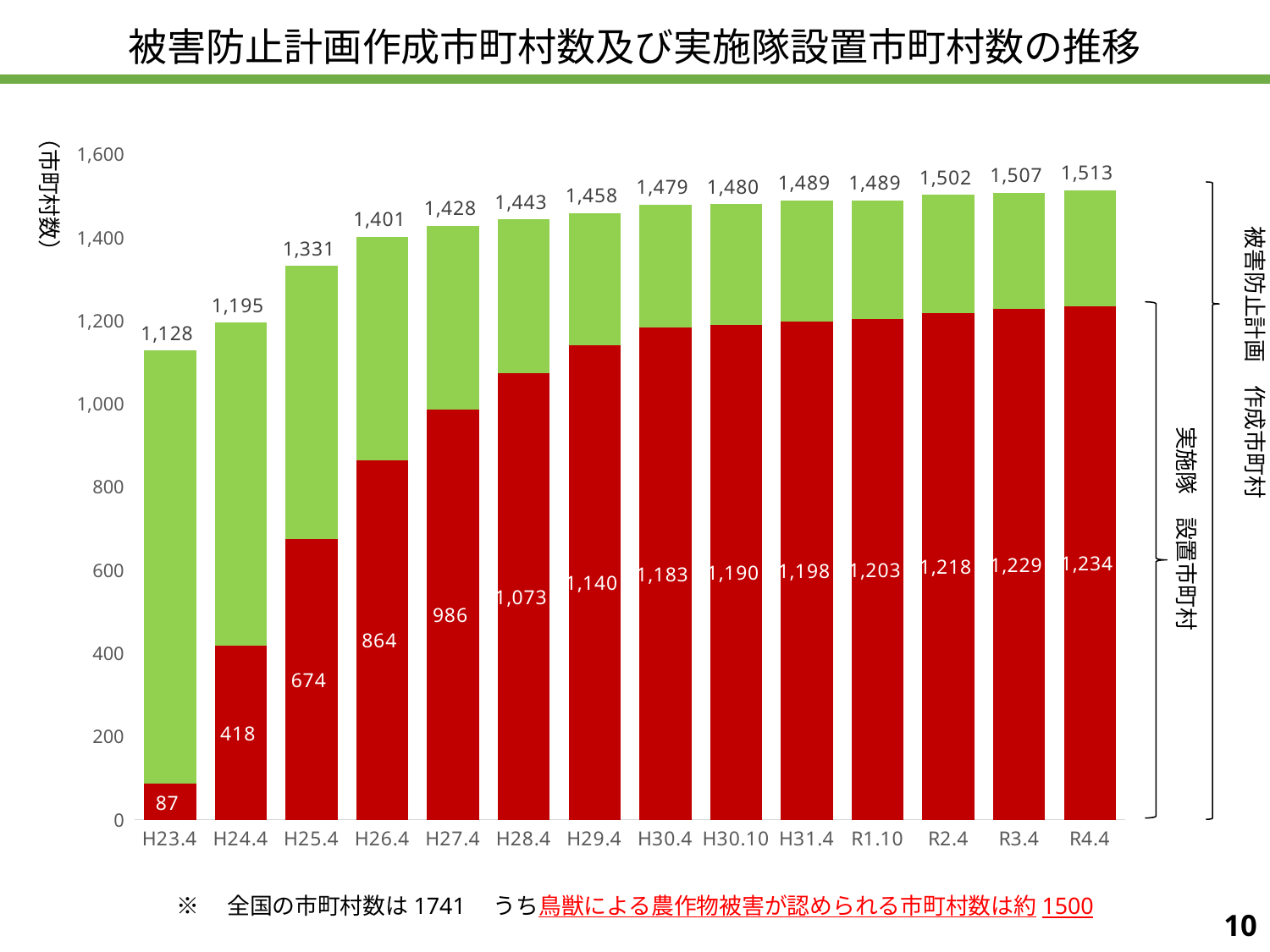
What is the number of 被害防止計画作成市町村 for H25.4? 1,331 What is the number of 実施隊設置市町村 for H27.4? 986 By how much did the number of 被害防止計画作成市町村 increase from H23.4 to R4.4? 385 How many time periods are shown on the x axis? 14 What is the number of 被害防止計画作成市町村 (value labelled at the top of the bar) for R4.4? 1,513 What is the number of 実施隊設置市町村 (red segment) for H23.4? 87 What kind of chart is shown on the slide? Stacked bar chart Which period has the lowest number of 実施隊設置市町村? H23.4 Do the numbers of 実施隊設置市町村 rise or fall from H23.4 to R4.4? Rise Which period has more 実施隊設置市町村, H25.4 or H26.4? H26.4 Which period has the highest number of 被害防止計画作成市町村? R4.4 What is the difference in 実施隊設置市町村 between H24.4 and H23.4? 331